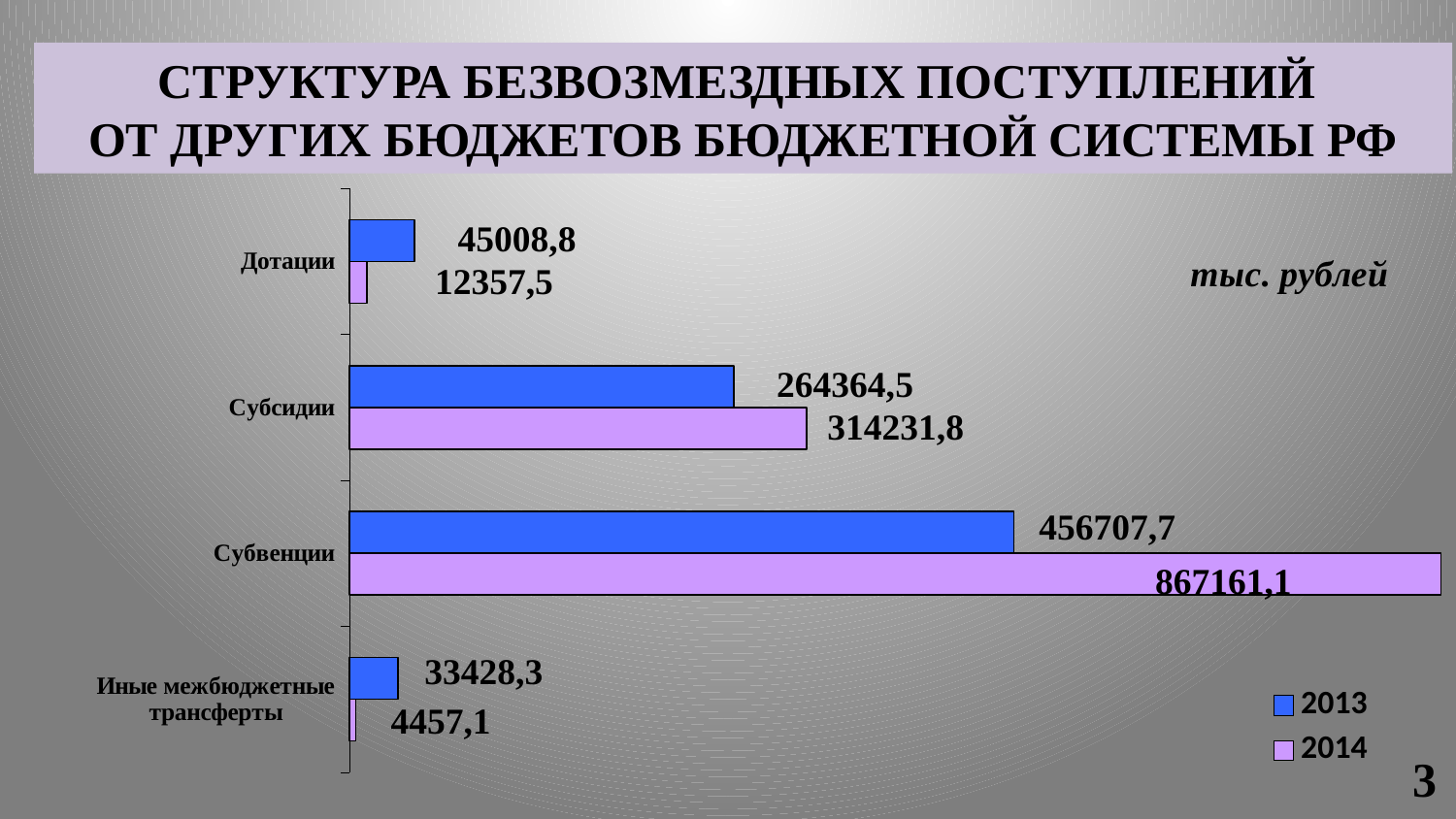
What is the difference between the 2014 and 2013 values for Субвенции? 410453,4 Which category has the lowest value in 2013? Иные межбюджетные трансферты How many categories are shown on the chart? 4 What is the value for Дотации in 2013? 45008,8 What is the 2013 value for Субсидии? 264364,5 What is the 2014 value for Иные межбюджетные трансферты? 4457,1 Which category has the highest value in 2014? Субвенции What is the difference between the 2013 and 2014 values for Дотации? 32651,3 What is the value for Субвенции in 2014? 867161,1 Which is larger for Субсидии, the 2013 value or the 2014 value? 2014 What kind of chart is shown on the slide? Bar chart How many series does the legend list? 2